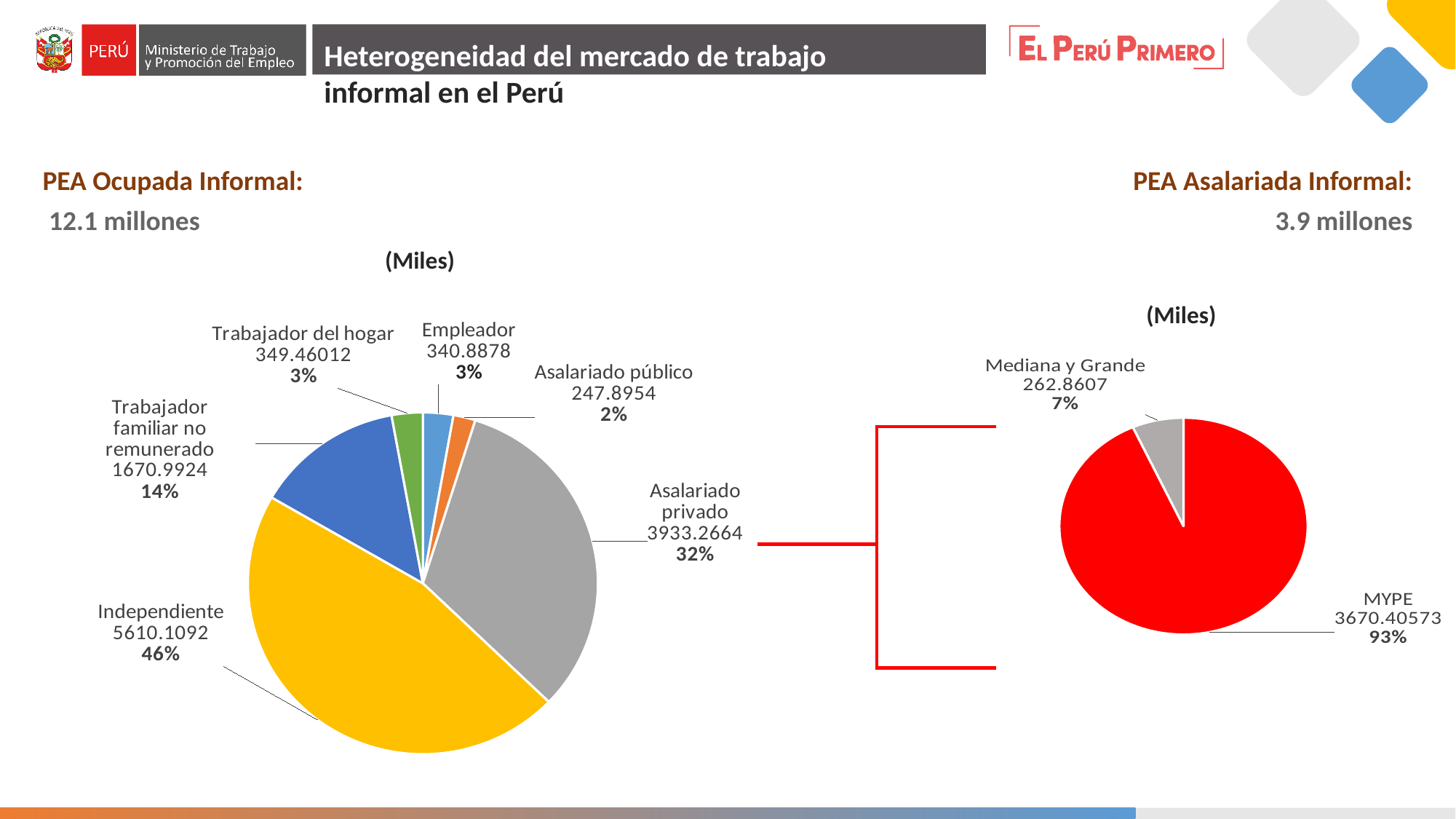
In the right pie chart (PEA Asalariada Informal), what is the value for MYPE? 3670.40573 In the right pie chart (PEA Asalariada Informal), what share does Mediana y Grande have? 7% In the right pie chart (PEA Asalariada Informal), what colour is the MYPE slice? red In the left pie chart (PEA Ocupada Informal), which category has the largest slice? Independiente In the left pie chart (PEA Ocupada Informal), how many categories are shown? 6 What kind of chart is the left chart under 'PEA Ocupada Informal'? pie chart In the left pie chart (PEA Ocupada Informal), what share does Asalariado privado have? 32% In the left pie chart (PEA Ocupada Informal), what is the value for Independiente? 5610.1092 In the left pie chart (PEA Ocupada Informal), what is the value for Trabajador familiar no remunerado? 1670.9924 In the left pie chart (PEA Ocupada Informal), which category has the smallest slice? Asalariado público In the left pie chart (PEA Ocupada Informal), which is larger: Trabajador del hogar or Empleador? Trabajador del hogar In the right pie chart (PEA Asalariada Informal), how many categories are shown? 2